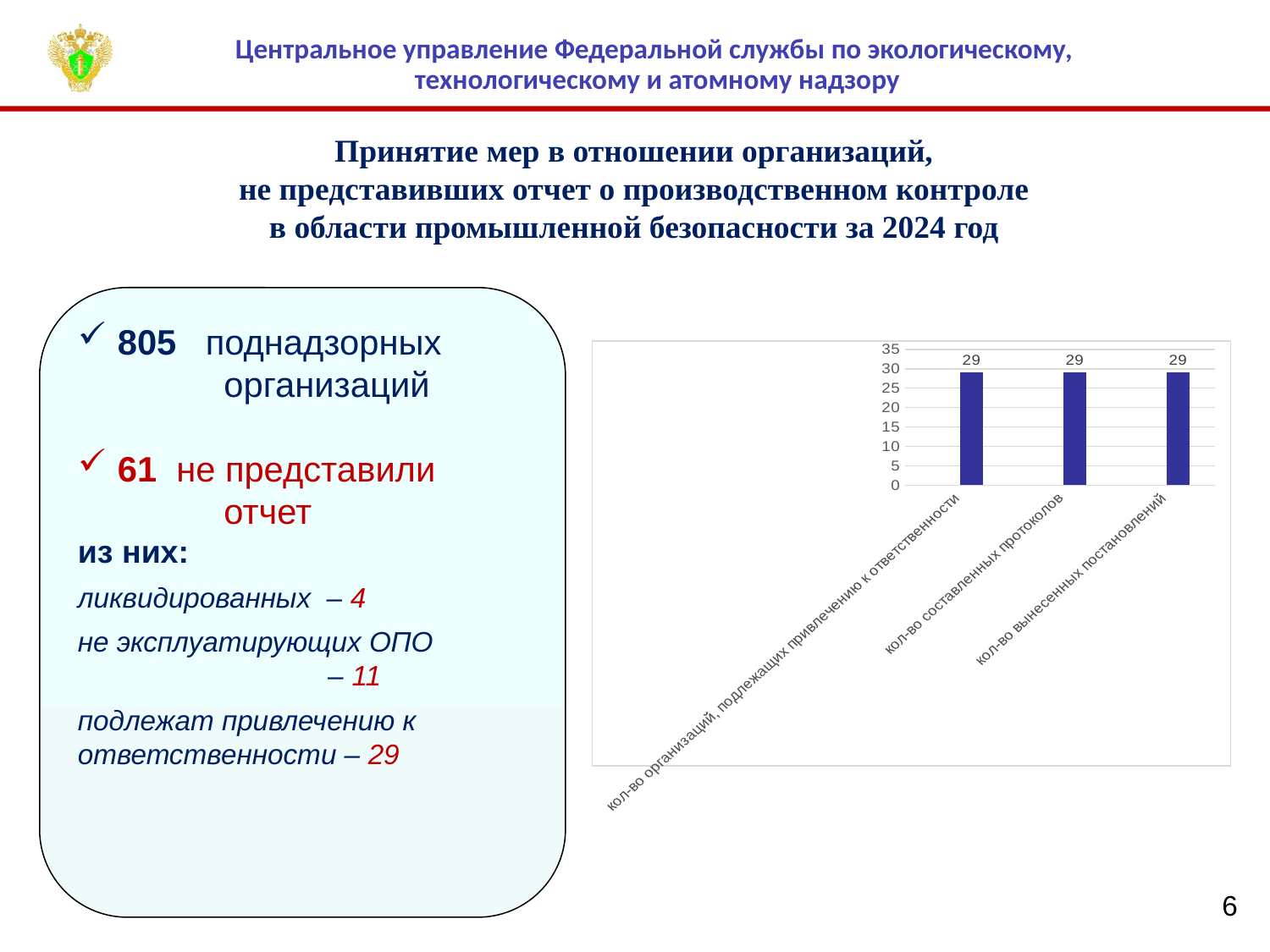
How many bars (categories) are shown in the chart? 3 Do the bar values rise, fall, or stay the same from left to right across the chart? stay the same What is the value for 'кол-во организаций, подлежащих привлечению к ответственности' in the bar chart? 29 Is the value for 'кол-во составленных протоколов' greater or less than 30? less What is the value for 'кол-во вынесенных постановлений' in the bar chart? 29 What kind of chart is shown on the slide? bar chart What is the highest tick value shown on the vertical axis of the chart? 35 What colour are the bars in the chart? blue What is the difference between the values for 'кол-во составленных протоколов' and 'кол-во вынесенных постановлений'? 0 Is the value for 'кол-во вынесенных постановлений' greater or less than 20? greater What is the value for 'кол-во составленных протоколов' in the bar chart? 29